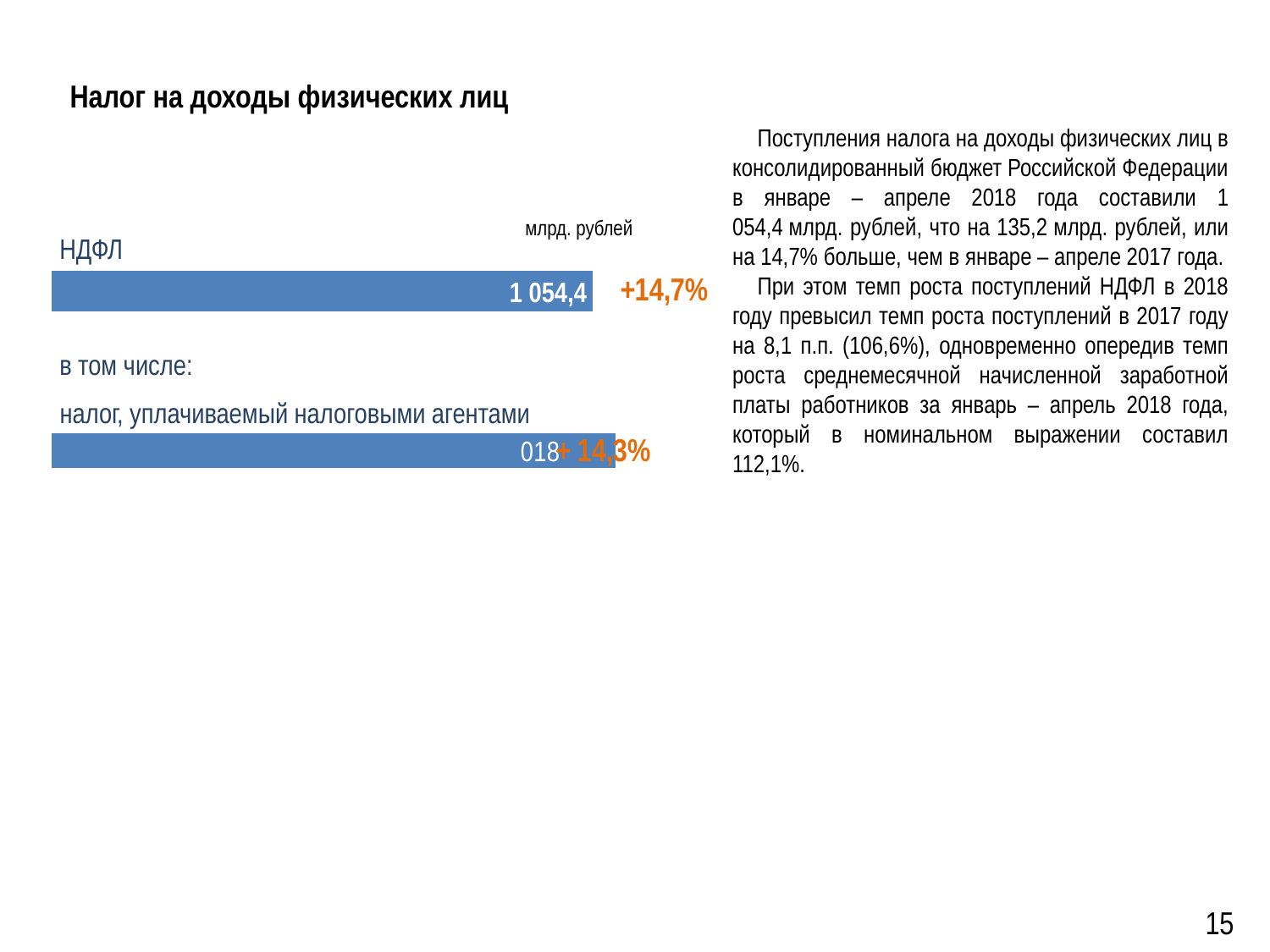
Which growth percentage is larger: the one for НДФЛ or the one for 'налог, уплачиваемый налоговыми агентами'? НДФЛ In what units are the chart values given? млрд. рублей What growth percentage is shown for 'налог, уплачиваемый налоговыми агентами'? +14,3% How many bars are shown in the chart? 2 What value is shown on the НДФЛ bar? 1 054,4 What is the title of the slide containing the chart? Налог на доходы физических лиц What kind of chart is shown on the slide? bar chart What growth percentage is shown next to the НДФЛ bar? +14,7%